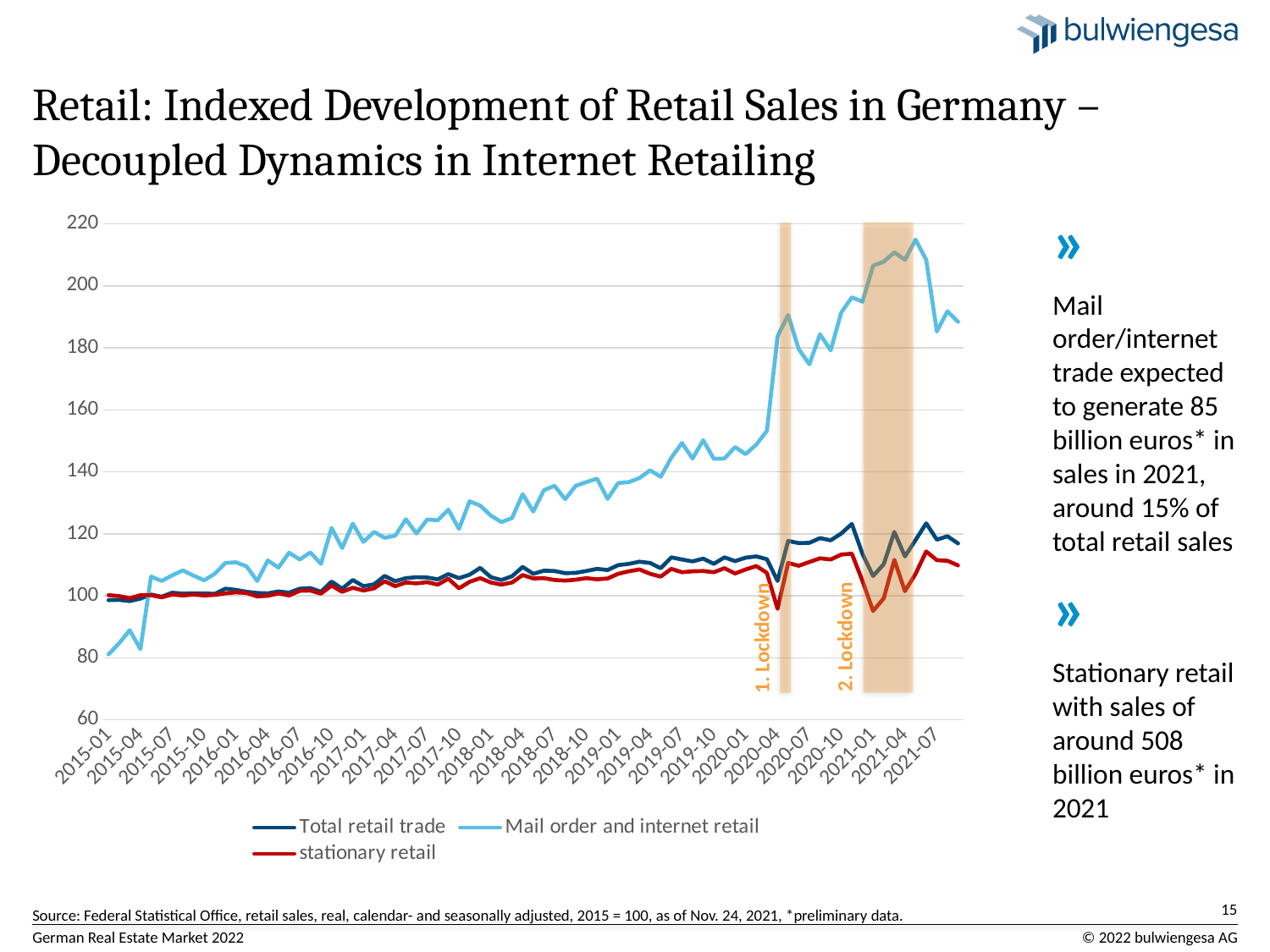
Which series reaches the highest value on the chart? Mail order and internet retail Which series has the lowest value at the end of the period (2021-07)? stationary retail What do the two shaded vertical bands on the chart mark? 1. Lockdown and 2. Lockdown How many series does the legend list? 3 Does the Mail order and internet retail series rise or fall overall from 2015-01 to 2021-07? rise Is the value for Mail order and internet retail at 2021-04 greater or less than 200? greater Is the value for Mail order and internet retail at 2020-04 greater or less than 160? greater Is the value for stationary retail at 2020-04 greater or less than 100? less Which series is drawn in red? stationary retail At 2021-07, which is larger: Mail order and internet retail or stationary retail? Mail order and internet retail What kind of chart is shown on the slide? line chart